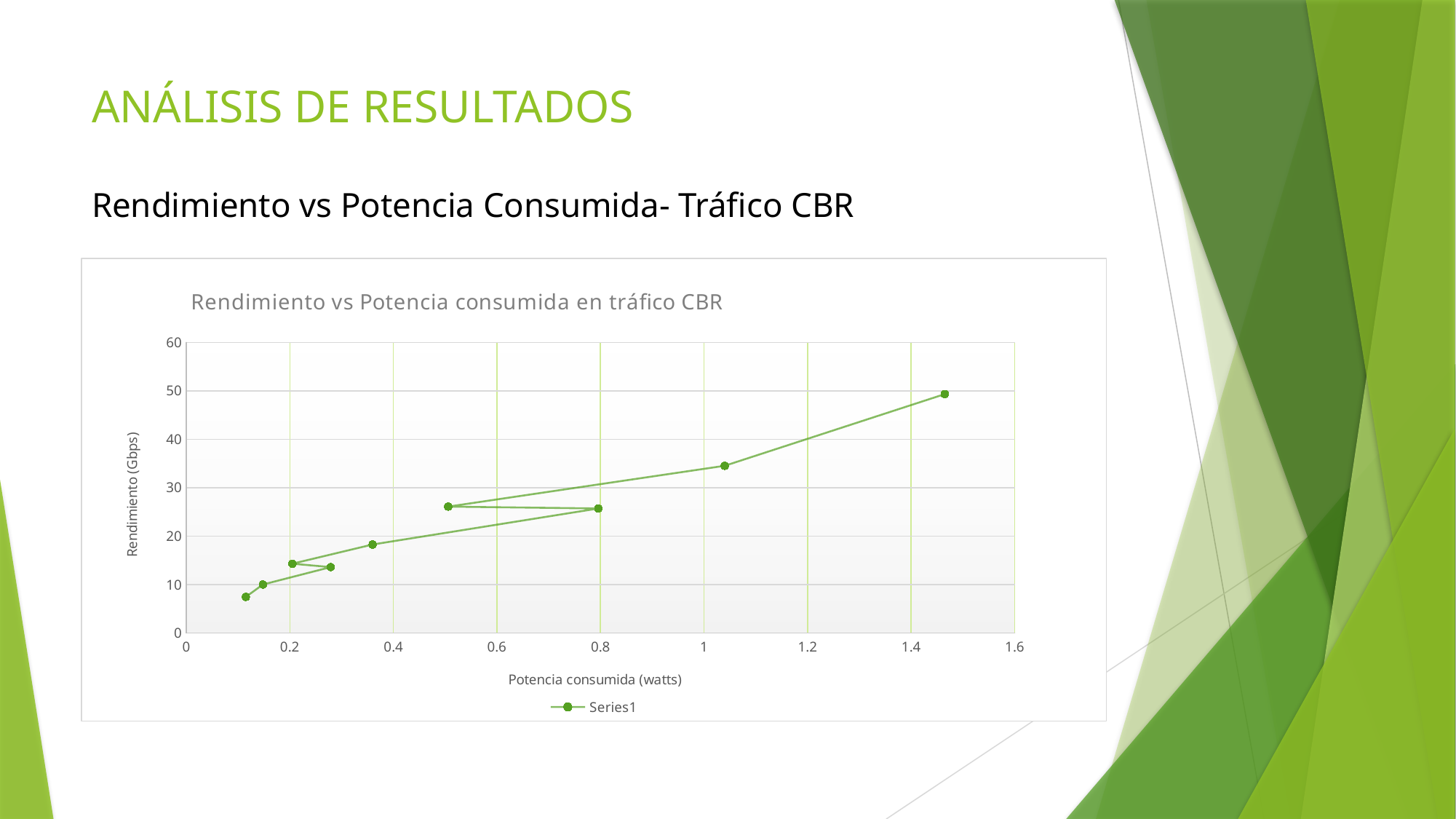
What kind of chart is shown on the slide? scatter chart with lines and markers Is the Rendimiento value for the point at about 0.36 watts greater or less than 20? less How many data points are plotted in the chart? 9 Is the Potencia consumida of the rightmost point greater or less than 1.4 watts? greater Is the highest plotted Rendimiento value greater or less than 40? greater Which has the higher Rendimiento: the point at about 1.47 watts or the point at about 1.04 watts? the point at about 1.47 watts What is the title of the chart? Rendimiento vs Potencia consumida en tráfico CBR Does the Rendimiento generally rise or fall as Potencia consumida increases? rise How many series does the legend list? 1 What is the label of the vertical axis? Rendimiento (Gbps)